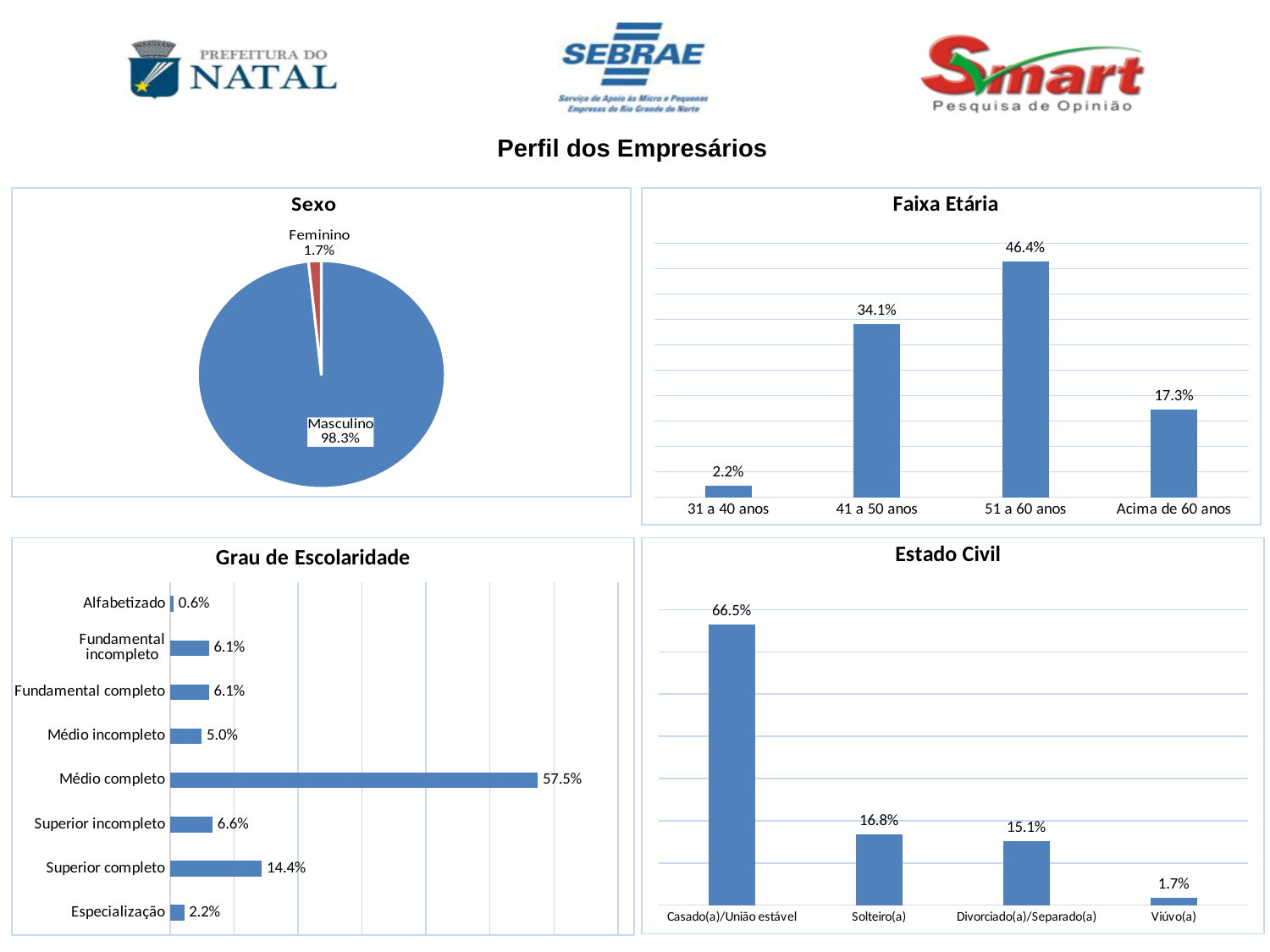
In the 'Grau de Escolaridade' chart, what kind of chart is shown? bar chart In the 'Faixa Etária' chart, what is the value for 41 a 50 anos? 34.1% In the 'Estado Civil' chart, which is larger, Solteiro(a) or Divorciado(a)/Separado(a)? Solteiro(a) In the 'Grau de Escolaridade' chart, how many categories are shown? 8 In the 'Faixa Etária' chart, how many age groups are shown? 4 In the 'Faixa Etária' chart, which age group has the highest value? 51 a 60 anos In the 'Grau de Escolaridade' chart, which category has the lowest value? Alfabetizado In the 'Grau de Escolaridade' chart, what is the value for Superior completo? 14.4% In the 'Sexo' chart, what share is Masculino? 98.3% In the 'Estado Civil' chart, what is the value for Viúvo(a)? 1.7% In the 'Faixa Etária' chart, what is the difference between 51 a 60 anos and Acima de 60 anos? 29.1% In the 'Sexo' chart, what kind of chart is shown? pie chart